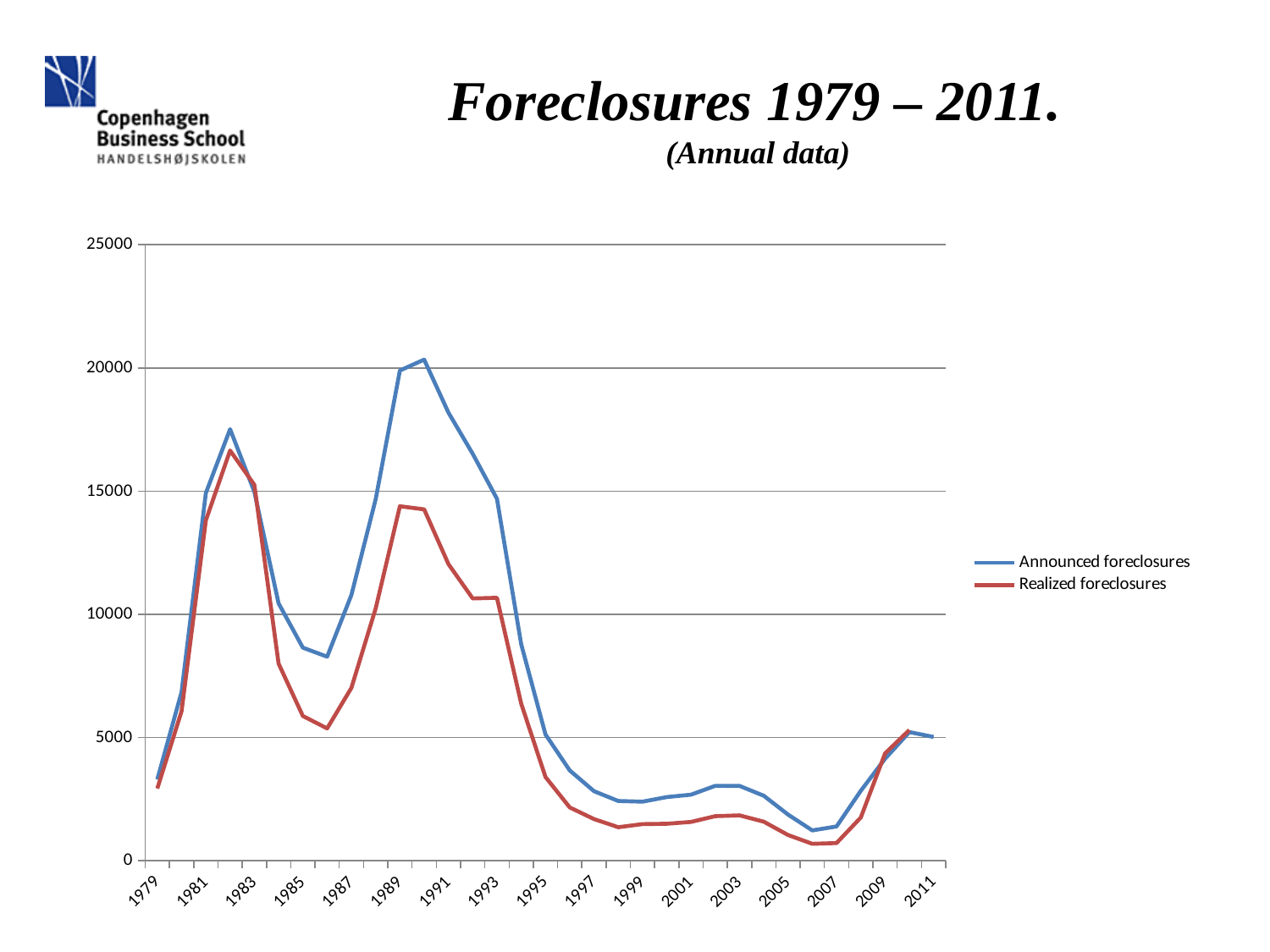
Which series is drawn in red? Realized foreclosures How many series does the legend list? 2 Is the value for Realized foreclosures in 2007 greater or less than 5000? less Do Announced foreclosures rise or fall between 1993 and 1997? Fall In which year do Announced foreclosures reach their highest value? 1990 What kind of chart is shown on the slide? Line chart Is the value for Announced foreclosures in 1982 greater or less than 15000? greater In which year do Realized foreclosures reach their highest value? 1982 Is the value for Announced foreclosures in 1985 greater or less than 10000? less What is the title of the chart on the slide? Foreclosures 1979 – 2011. (Annual data) In 1990, which is larger: Announced foreclosures or Realized foreclosures? Announced foreclosures